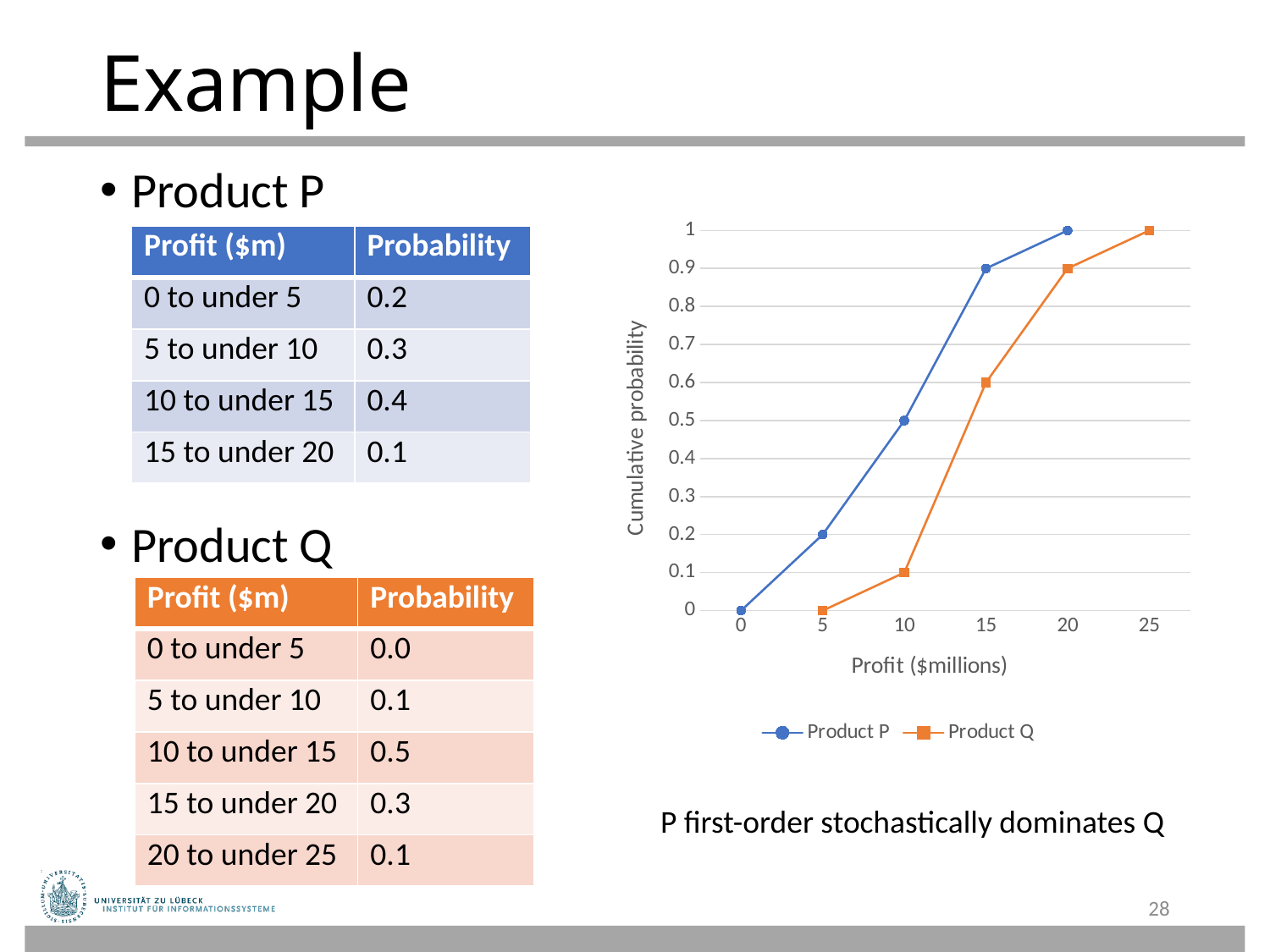
At a profit of 10 ($millions), which series has the higher cumulative probability, Product P or Product Q? Product P How many data points are plotted for Product Q? 5 How many series does the chart legend list? 2 What is the cumulative probability for Product P at a profit of 10 ($millions)? 0.5 Do the cumulative probability values for Product Q rise or fall as profit increases along the x axis? rise What is the difference between the cumulative probabilities of Product P and Product Q at a profit of 15 ($millions)? 0.3 What is the label of the y axis of the chart? Cumulative probability What is the cumulative probability for Product P at a profit of 15 ($millions)? 0.9 What is the cumulative probability for Product Q at a profit of 10 ($millions)? 0.1 What is the cumulative probability for Product Q at a profit of 15 ($millions)? 0.6 What kind of chart is shown on the slide? line chart Is the cumulative probability for Product P at a profit of 5 ($millions) greater or less than 0.5? less